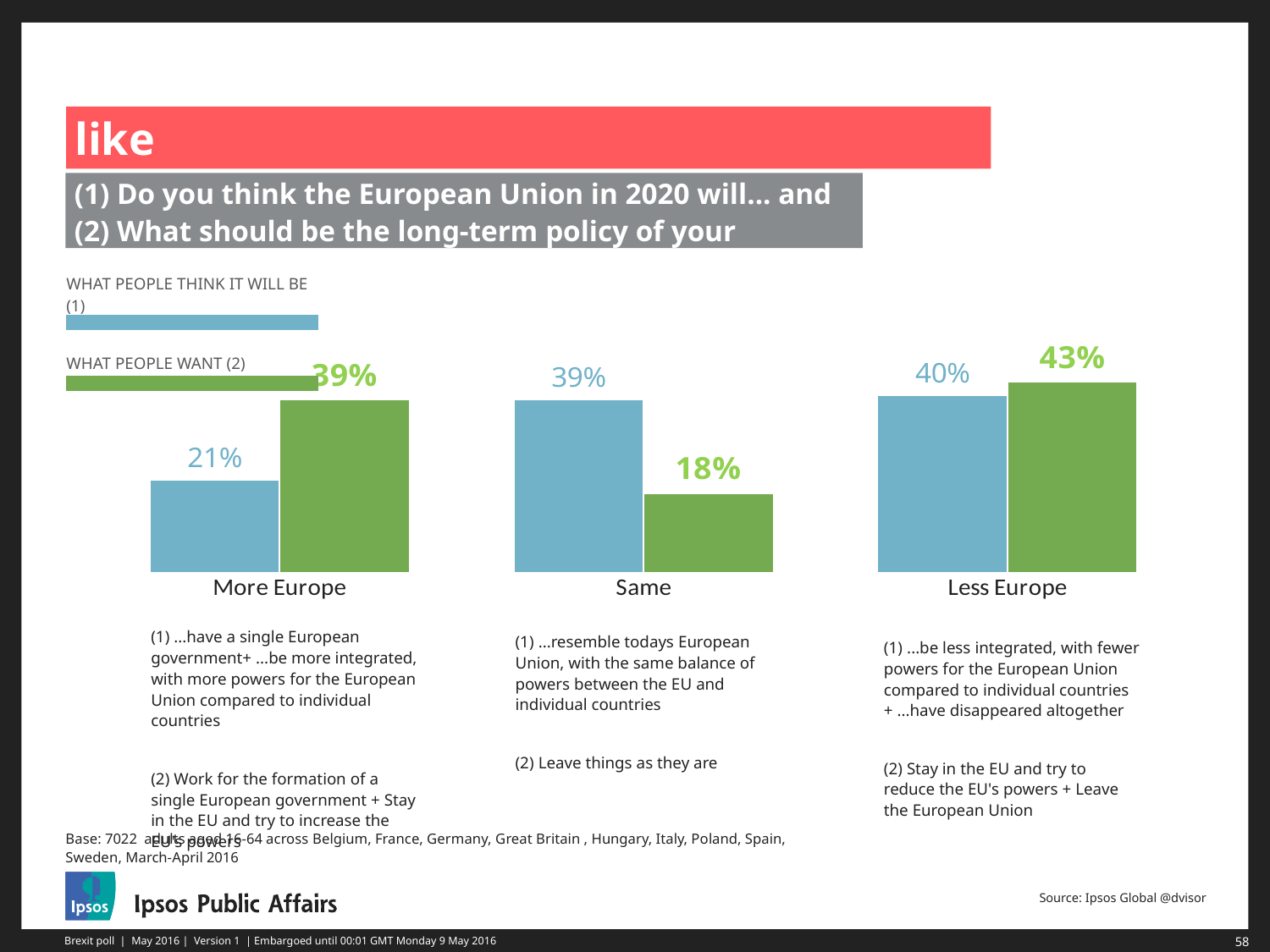
Which category has the highest value for 'What people want (2)'? Less Europe Which category has the lowest value for 'What people think it will be (1)'? More Europe What percentage of people think the EU in 2020 will be 'More Europe' (the blue bar)? 21% What kind of chart is shown on the slide? Bar chart What is the value of the 'What people want (2)' bar for 'Same'? 18% What is the difference between the 'What people want' and 'What people think it will be' values for 'More Europe'? 18% What percentage of people want 'More Europe' (the green bar)? 39% How many categories are shown on the x axis of the chart? 3 Which colour represents 'What people want (2)' in the chart? Green How many series does the chart's legend list? 2 What is the value of the 'What people think it will be (1)' bar for 'Less Europe'? 40% For 'Same', which is larger: what people think it will be or what people want? What people think it will be